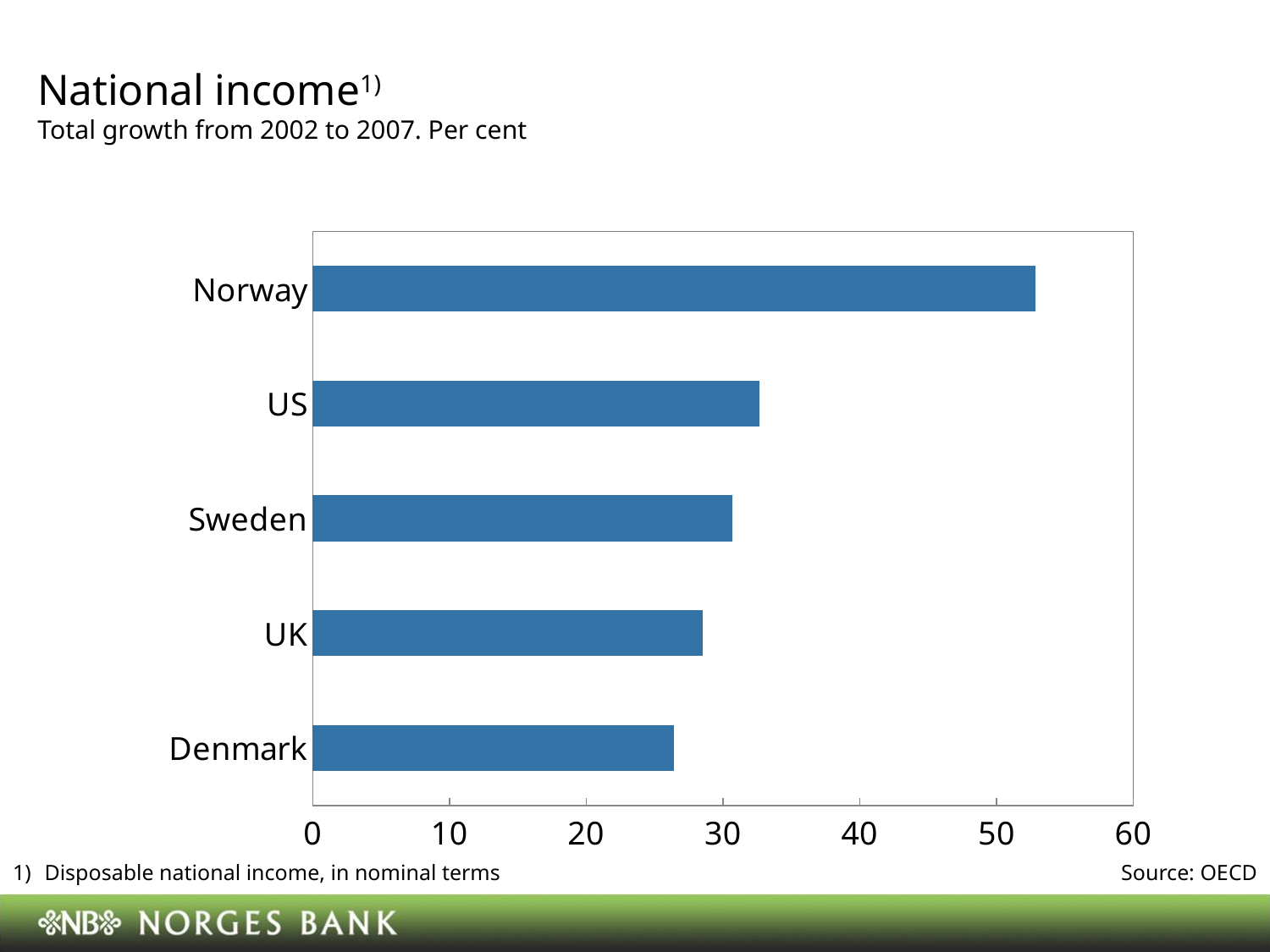
Which has the larger value, Sweden or Denmark? Sweden Is the value for Sweden greater or less than 40? less What is the source cited for the chart? OECD Is the value for UK greater or less than 30? less Which country has the highest total growth in national income? Norway Which country has the lowest total growth in national income? Denmark Which has the larger value, Norway or US? Norway Is the value for US greater or less than 30? greater What kind of chart is shown on the slide? bar chart How many countries are shown in the chart? 5